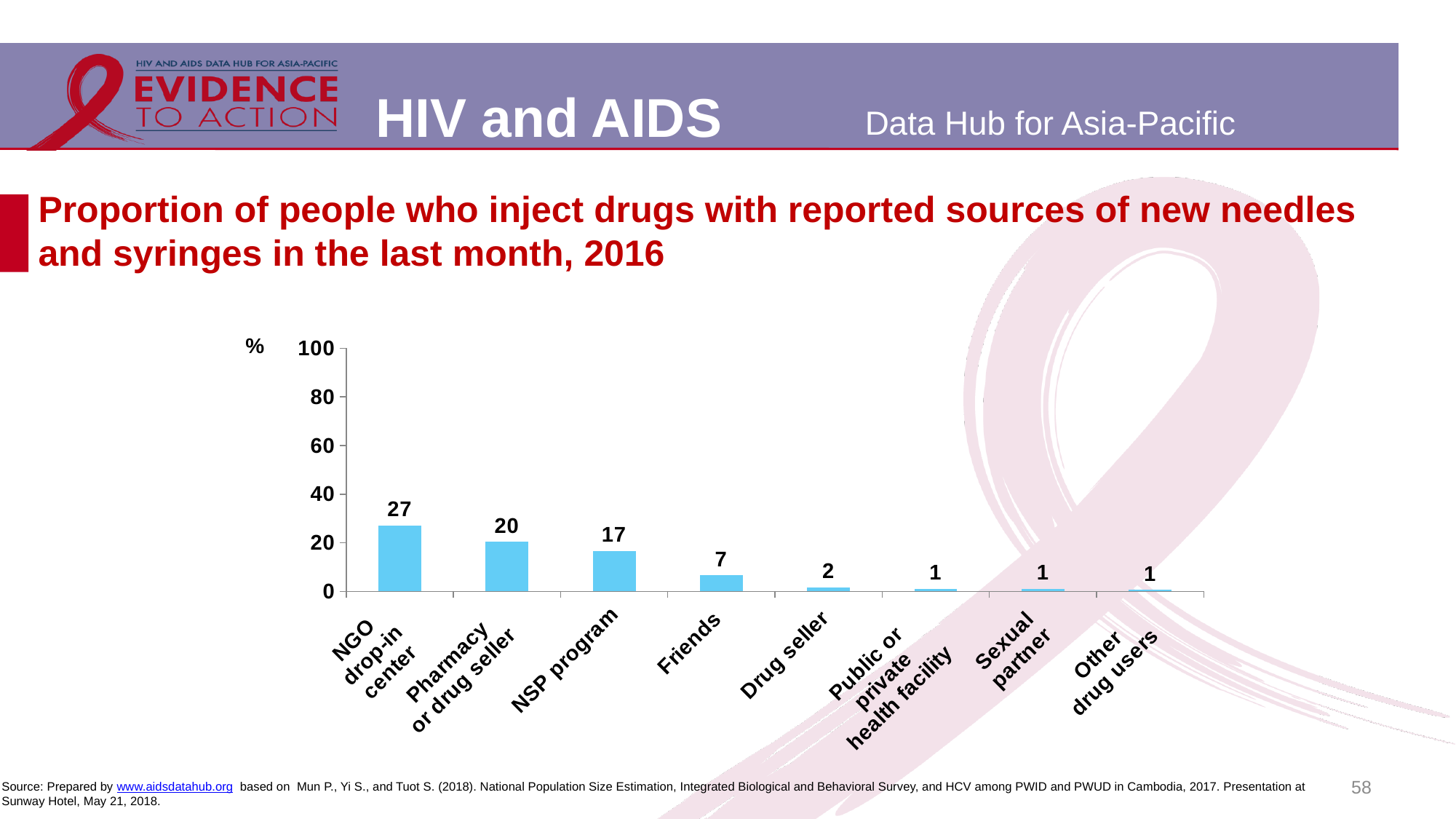
What is the value for NSP program? 17 Which is larger, the value for Friends or the value for Drug seller? Friends What is the value for Pharmacy or drug seller? 20 What is the difference between the values for NGO drop-in center and NSP program? 10 What kind of chart is shown on the slide? bar chart What is the value for NGO drop-in center? 27 What unit is shown on the y axis? % What is the difference between the values for Pharmacy or drug seller and Friends? 13 What is the value for Friends? 7 Is the value for NGO drop-in center greater or less than 20? greater Which source has the highest value? NGO drop-in center How many categories are shown on the x axis? 8